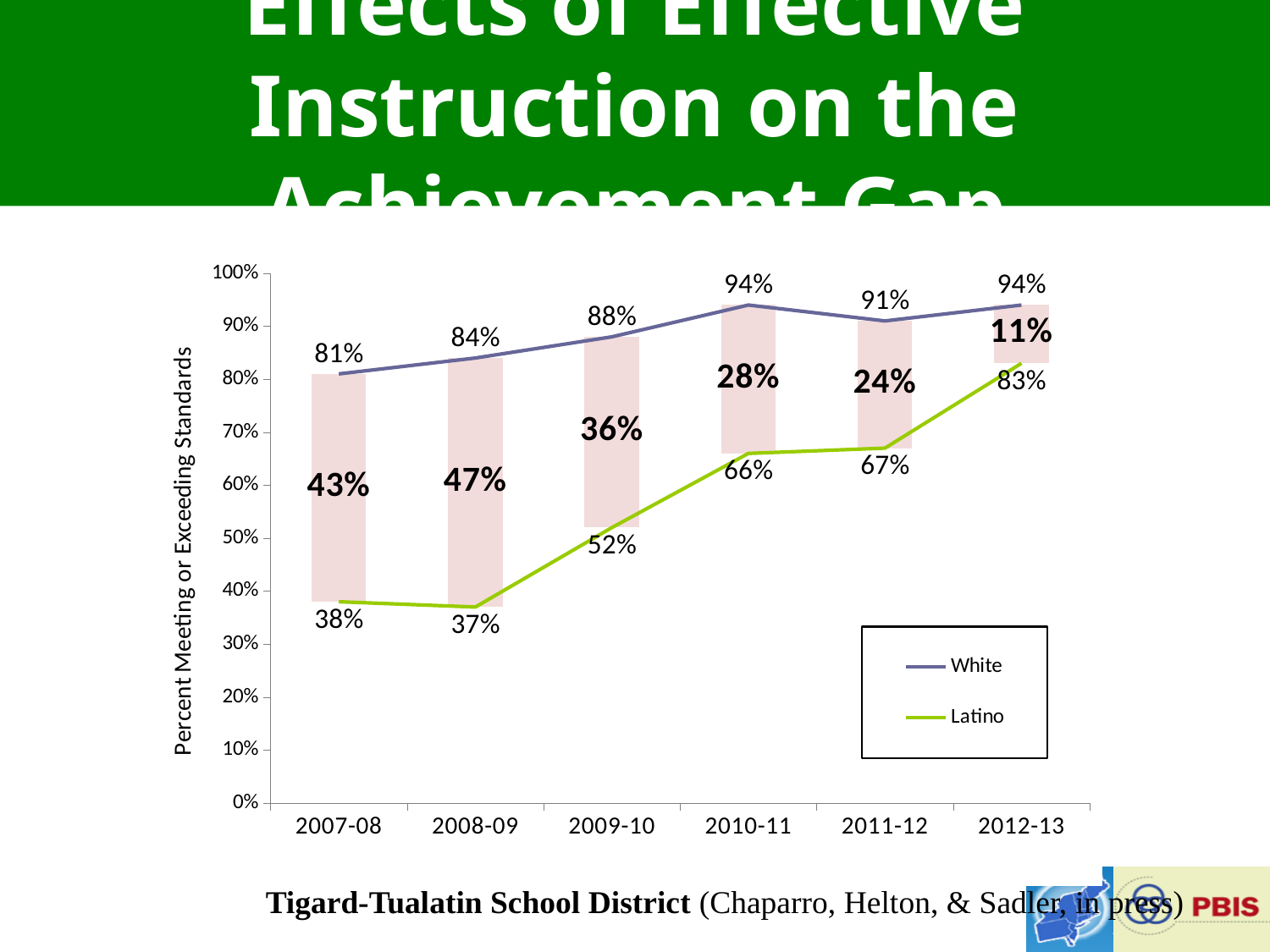
How many school years are shown on the x axis? 6 What is the value for Latino in 2009-10? 52% What is the value for White in 2007-08? 81% What is the value for Latino in 2012-13? 83% What kind of chart is shown on the slide? combination bar and line chart What is the difference between the White and Latino values in 2012-13? 11% What is the difference between the White and Latino values in 2008-09? 47% What is the label on the y axis? Percent Meeting or Exceeding Standards How many series does the legend list? 2 In which year is the Latino value lowest? 2008-09 Does the Latino value rise or fall from 2008-09 to 2012-13? rise Which is larger, the Latino value in 2010-11 or the Latino value in 2009-10? 2010-11